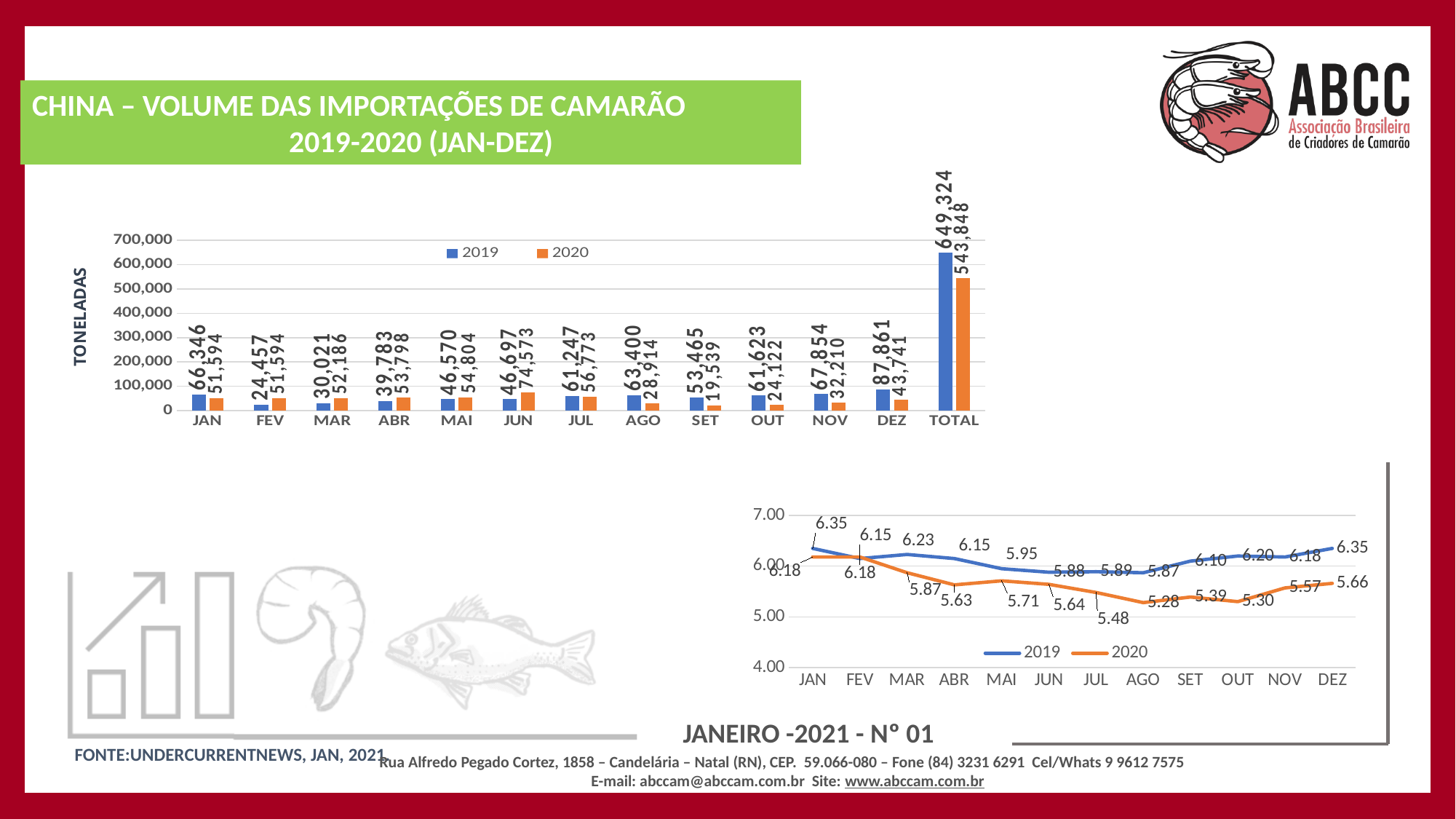
In the top bar chart, which month has the lowest 2020 value? SET In the bottom line chart, what is the 2020 value for AGO? 5.28 In the top bar chart, which series has the larger value for JUL, 2019 or 2020? 2019 In the bottom line chart, which month has the lowest 2020 value? AGO In the top bar chart, which month has the lowest 2019 value? FEV In the top bar chart, what is the TOTAL value for 2020? 543,848 How many series does the legend of the bottom line chart list? 2 In the top bar chart, what is the difference between the 2019 and 2020 TOTAL values? 105,476 In the top bar chart, how many categories are shown on the x axis? 13 What kind of chart is the top chart on the slide? Bar chart In the top bar chart, what was the 2020 import volume for JUN? 74,573 In the top bar chart, what was the 2019 import volume for DEZ? 87,861